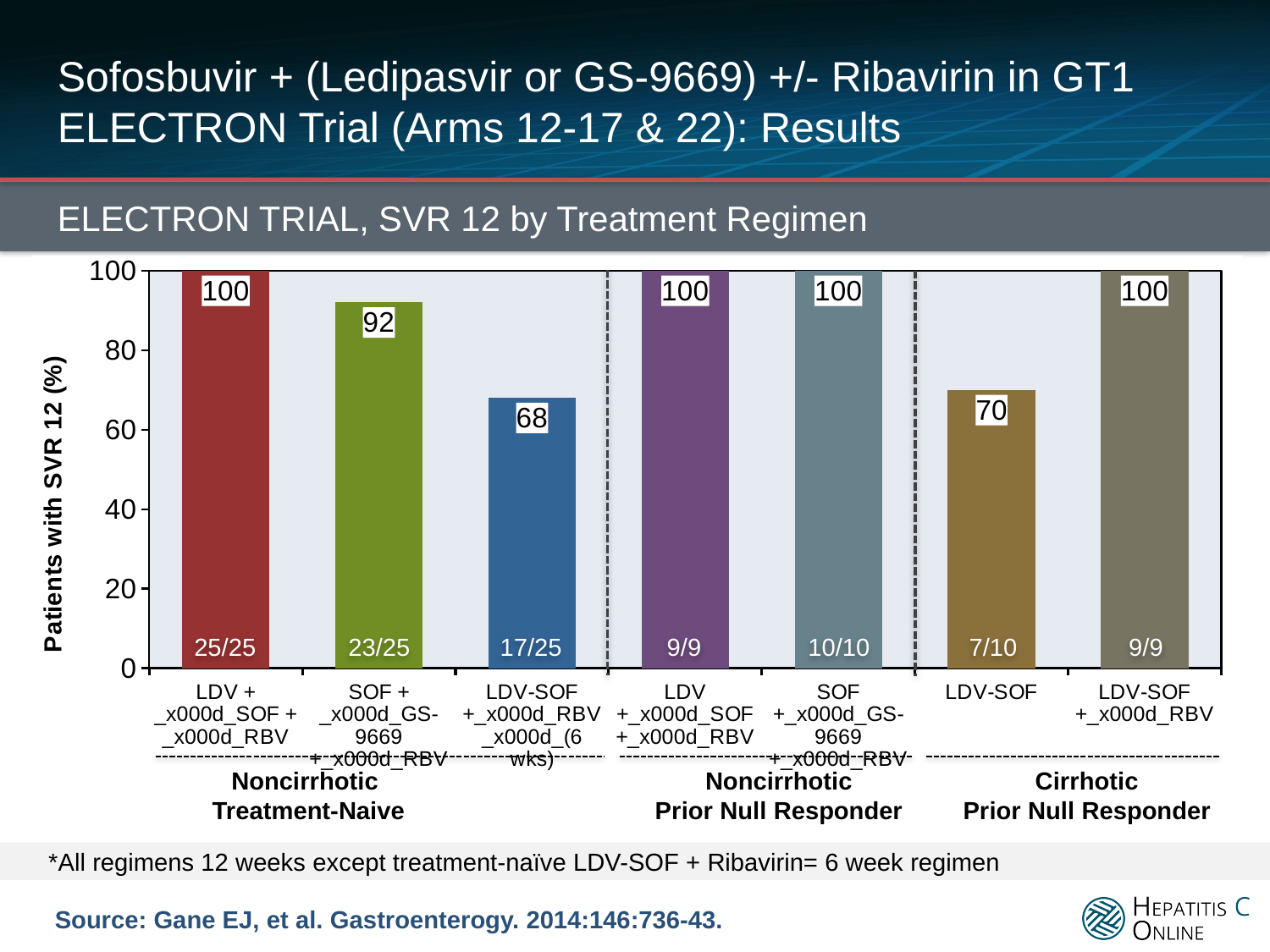
How many bars (treatment regimens) are shown on the chart? 7 What fraction of patients achieved SVR 12 with SOF + GS-9669 + RBV in the noncirrhotic prior null responder group? 10/10 What type of chart is used to show SVR 12 by treatment regimen? Bar chart What is the SVR 12 rate for the SOF + GS-9669 + RBV regimen in the noncirrhotic treatment-naive group? 92 How many patients achieved SVR 12 out of how many treated with LDV-SOF in the cirrhotic prior null responder group? 7/10 What is the label of the y-axis on the chart? Patients with SVR 12 (%) What is the SVR 12 rate for the 6-week LDV-SOF + RBV regimen in the noncirrhotic treatment-naive group? 68 What is the difference in SVR 12 rate between the SOF + GS-9669 + RBV regimen (92) and the 6-week LDV-SOF + RBV regimen (68) in the treatment-naive group? 24 What is the SVR 12 rate for LDV-SOF (without RBV) in the cirrhotic prior null responder group? 70 Which has a higher SVR 12 rate in the cirrhotic prior null responder group: LDV-SOF alone or LDV-SOF + RBV? LDV-SOF + RBV Which regimen has the lowest SVR 12 rate on the chart? LDV-SOF + RBV (6 wks) in noncirrhotic treatment-naive patients How many bars on the chart reach an SVR 12 rate of 100? 4